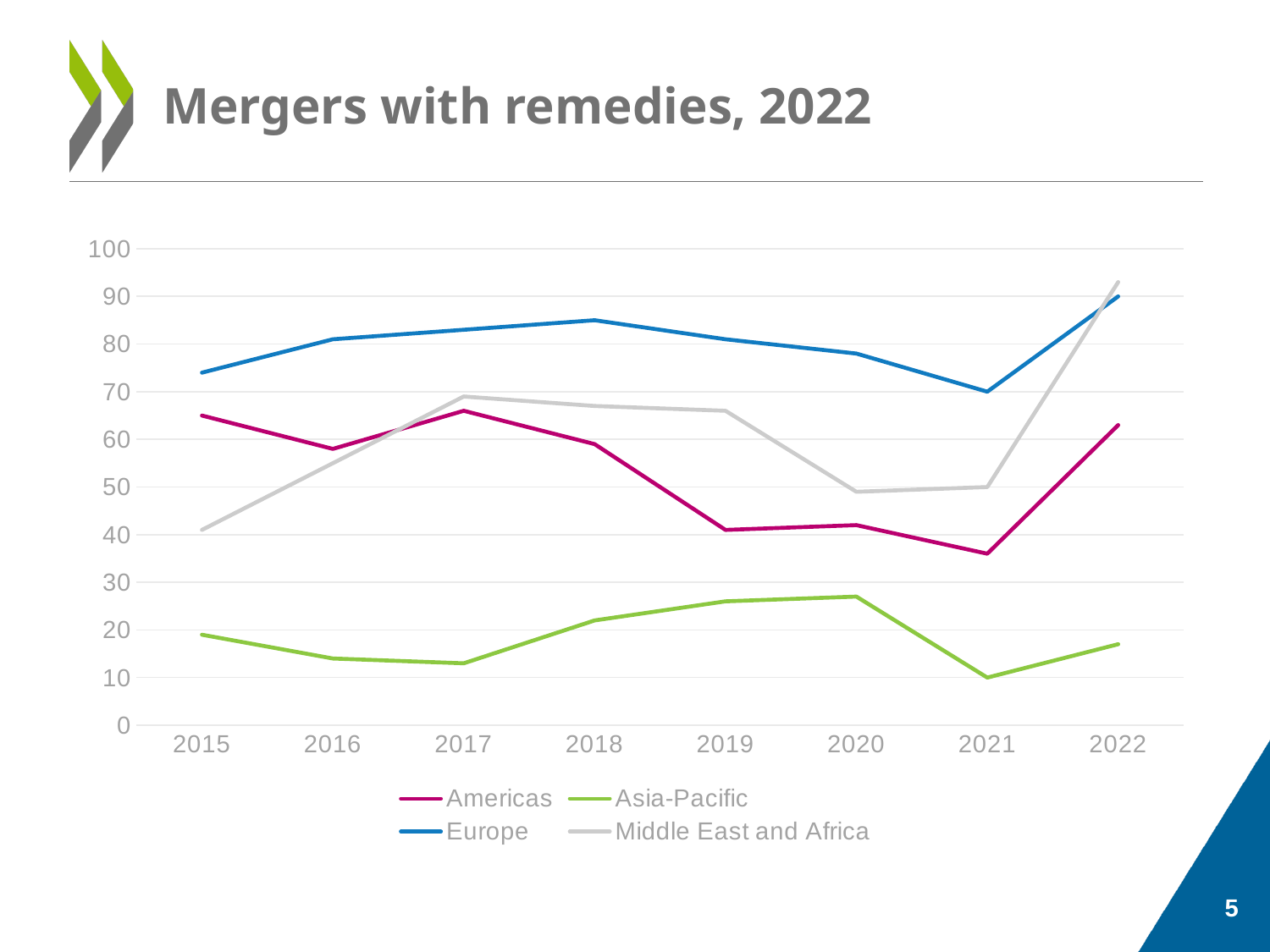
Does the Asia-Pacific line rise or fall from 2021 to 2022? Rises How many series does the legend list? 4 How many years are shown on the x axis? 8 Is the value for Middle East and Africa in 2015 greater or less than 50? less What kind of chart is shown on the slide? Line chart What is the title of the slide? Mergers with remedies, 2022 In 2019, which is larger: the value for Americas or the value for Middle East and Africa? Middle East and Africa Which series has the lowest value in 2021? Asia-Pacific Is the value for Europe in 2018 greater or less than 80? greater Does the Europe line rise or fall from 2018 to 2021? Falls Is the value for Americas in 2021 greater or less than 40? less Which series has the highest value in 2018? Europe